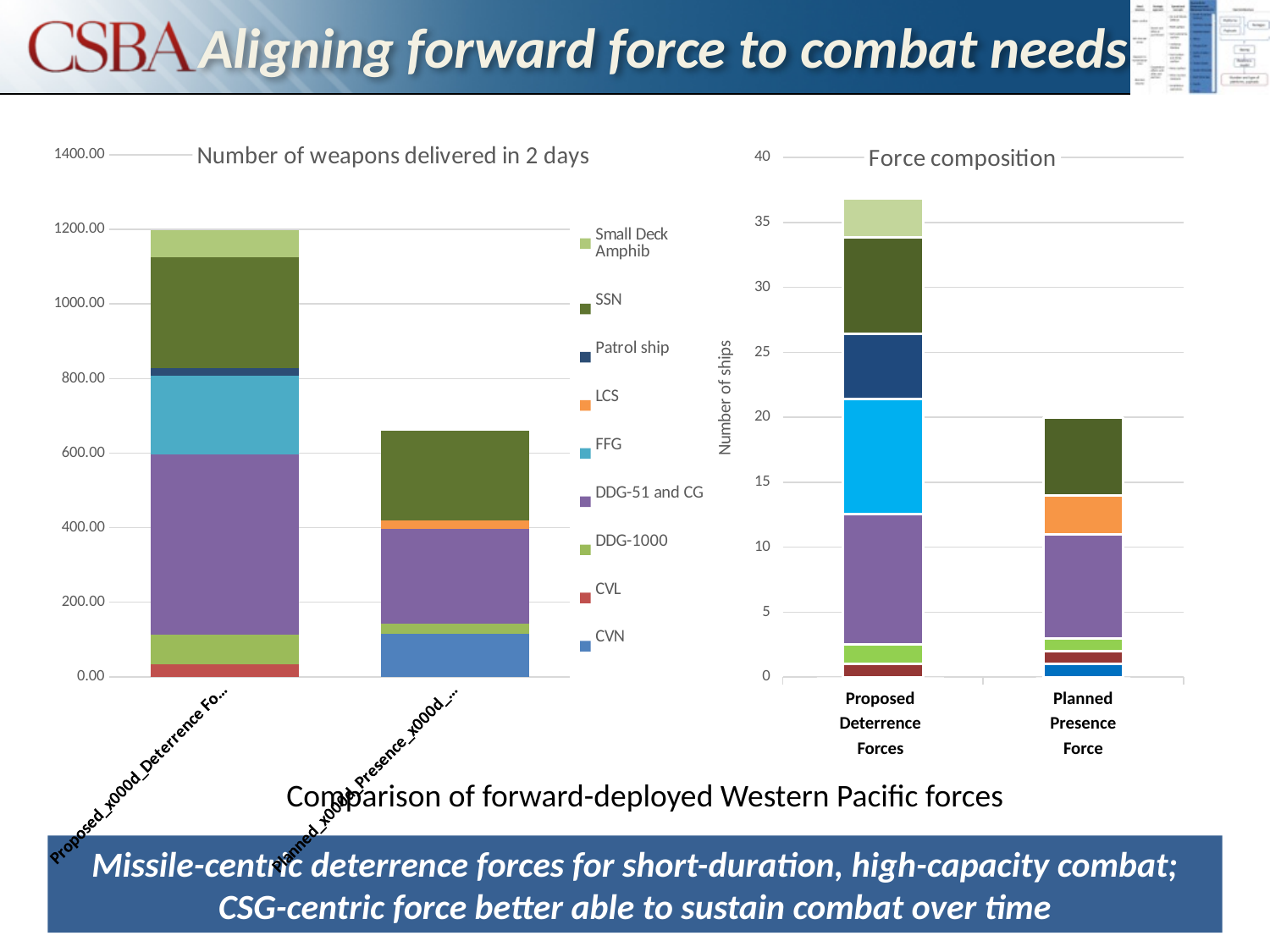
In the 'Force composition' chart, is the total for Proposed Deterrence Forces greater or less than 35? greater In the 'Force composition' chart, which has the larger total: Proposed Deterrence Forces or Planned Presence Force? Proposed Deterrence Forces In the 'Force composition' chart, how many categories are shown on the x axis? 2 In the 'Number of weapons delivered in 2 days' chart, is the total of the left-hand (Proposed Deterrence) bar greater or less than 1000.00? greater In the 'Number of weapons delivered in 2 days' chart, how many stacked bars are plotted? 2 What kind of chart is the 'Force composition' chart? bar chart How many series does the legend between the two charts list? 9 In the 'Force composition' chart, which category has the highest total number of ships? Proposed Deterrence Forces What is the y-axis label of the 'Force composition' chart? Number of ships In the 'Number of weapons delivered in 2 days' chart, is the total of the right-hand (Planned Presence) bar greater or less than 800.00? less What kind of chart is the 'Number of weapons delivered in 2 days' chart? bar chart